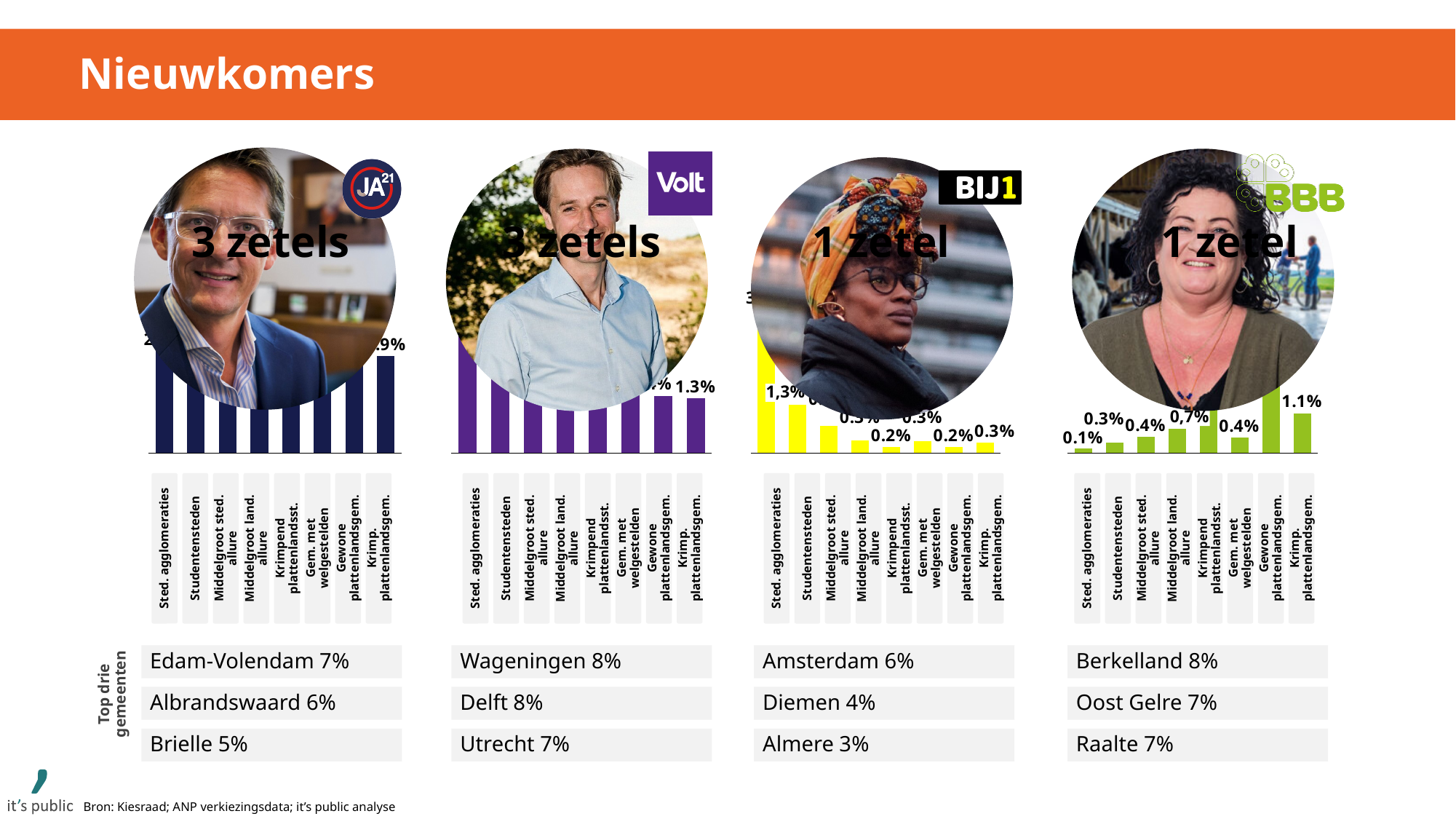
In the Volt chart (second from left), what is the value for Krimp. plattenlandsgem.? 1.3% In the BBB chart (rightmost), which is larger: Middelgroot land. allure or Studentensteden? Middelgroot land. allure In the BBB chart (rightmost), what is the difference between Krimp. plattenlandsgem. and Sted. agglomeraties? 1.0% How many categories are shown on the x axis of the JA21 chart (leftmost chart)? 8 In the BBB chart (rightmost), what is the value for Middelgroot land. allure? 0.7% In the BIJ1 chart (third from left), which category has the highest value? Sted. agglomeraties In the BBB chart (rightmost), which category has the lowest value? Sted. agglomeraties What kind of chart is used for the BBB party (rightmost chart)? Bar chart In the BBB chart (rightmost), what is the value for Krimp. plattenlandsgem.? 1.1% In the BBB chart (rightmost), what is the value for Sted. agglomeraties? 0.1%